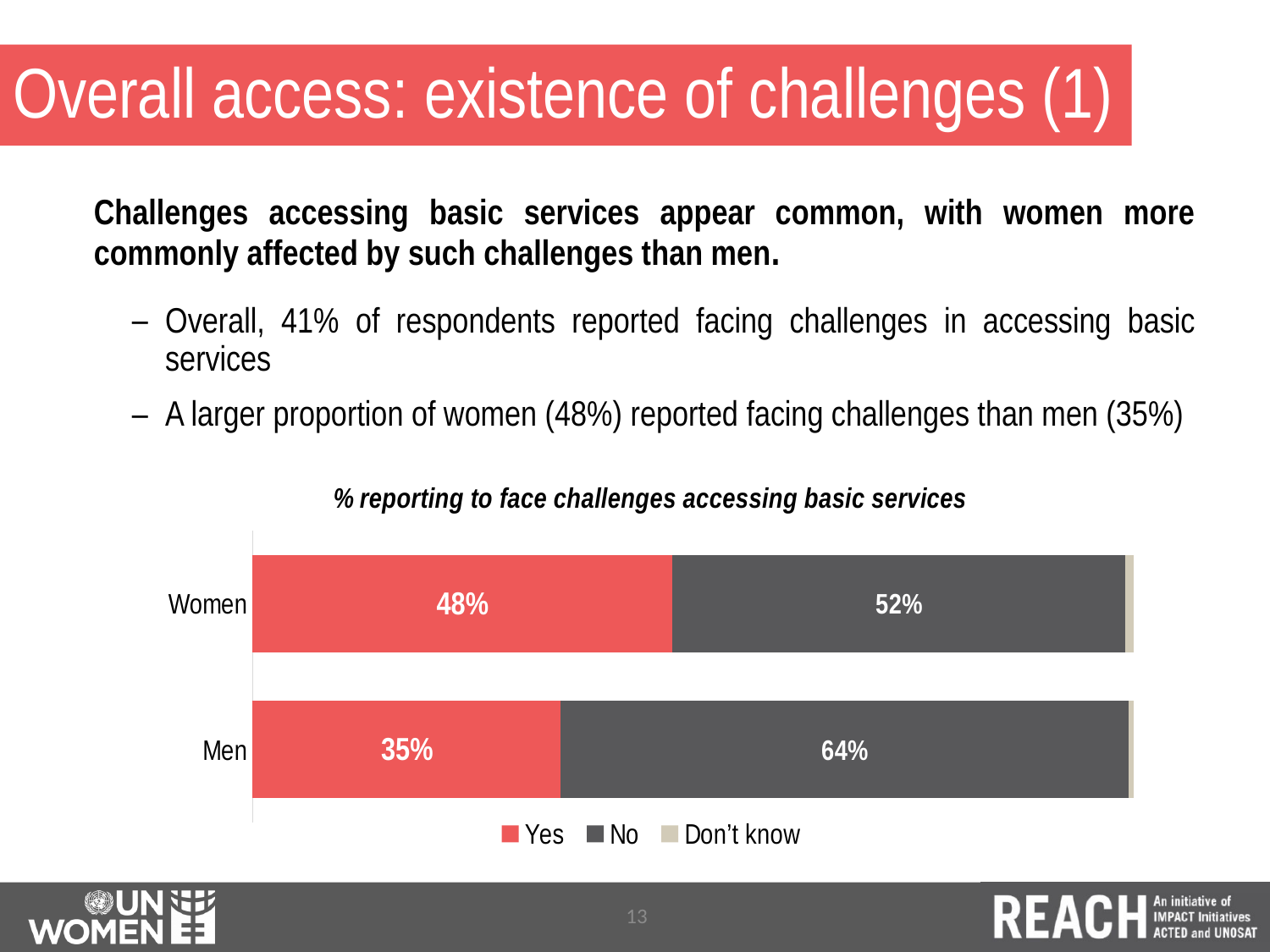
What type of chart is shown on the slide? Stacked bar chart What percentage of women reported facing challenges accessing basic services (Yes)? 48% What is the 'No' value for women in the chart? 52% What is the difference in percentage points between the 'No' values for men and women? 12 What is the title of the chart? % reporting to face challenges accessing basic services What is the 'No' value for men in the chart? 64% What percentage of men reported facing challenges accessing basic services (Yes)? 35% What is the difference in percentage points between the 'Yes' values for women and men? 13 How many categories (groups) are shown on the chart? 2 How many series does the legend list? 3 Which group has the higher 'No' share, women or men? Men Which group has the higher 'Yes' share, women or men? Women